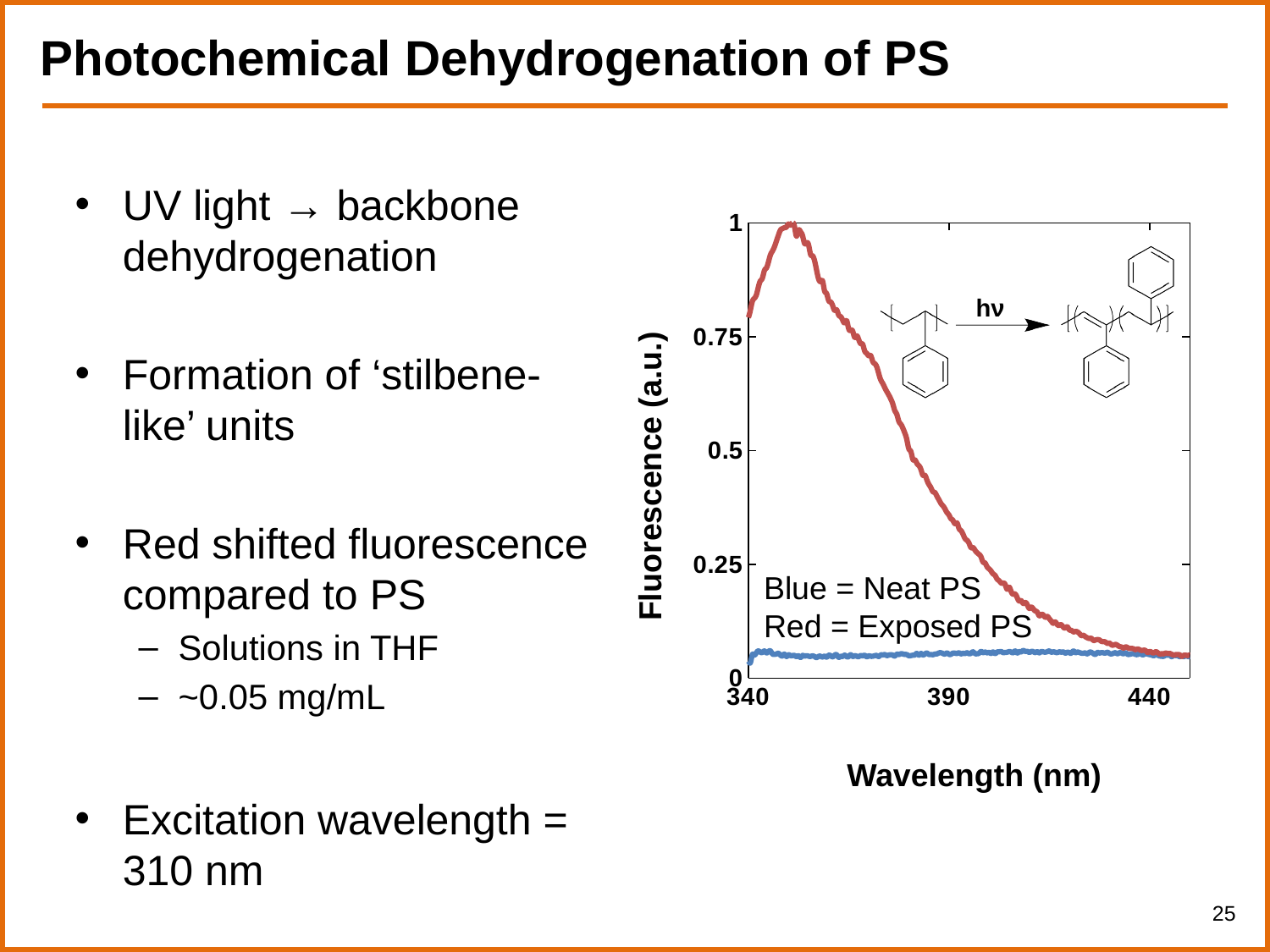
How many data series are plotted in the chart? 2 What is the label of the y axis of the chart? Fluorescence (a.u.) At 390 nm, which series has the larger fluorescence, Neat PS or Exposed PS? Exposed PS What is the label of the x axis of the chart? Wavelength (nm) Does the fluorescence of Exposed PS rise or fall between 390 nm and 440 nm? fall Which series does the red line represent? Exposed PS What kind of chart is shown on the slide? line chart Which series reaches the higher fluorescence value, Neat PS or Exposed PS? Exposed PS Is the fluorescence of Exposed PS at 440 nm greater or less than 0.25? less Is the peak fluorescence of Exposed PS greater or less than 0.75? greater What is the lowest wavelength shown on the x axis? 340 Is the fluorescence of Neat PS at 390 nm greater or less than 0.25? less